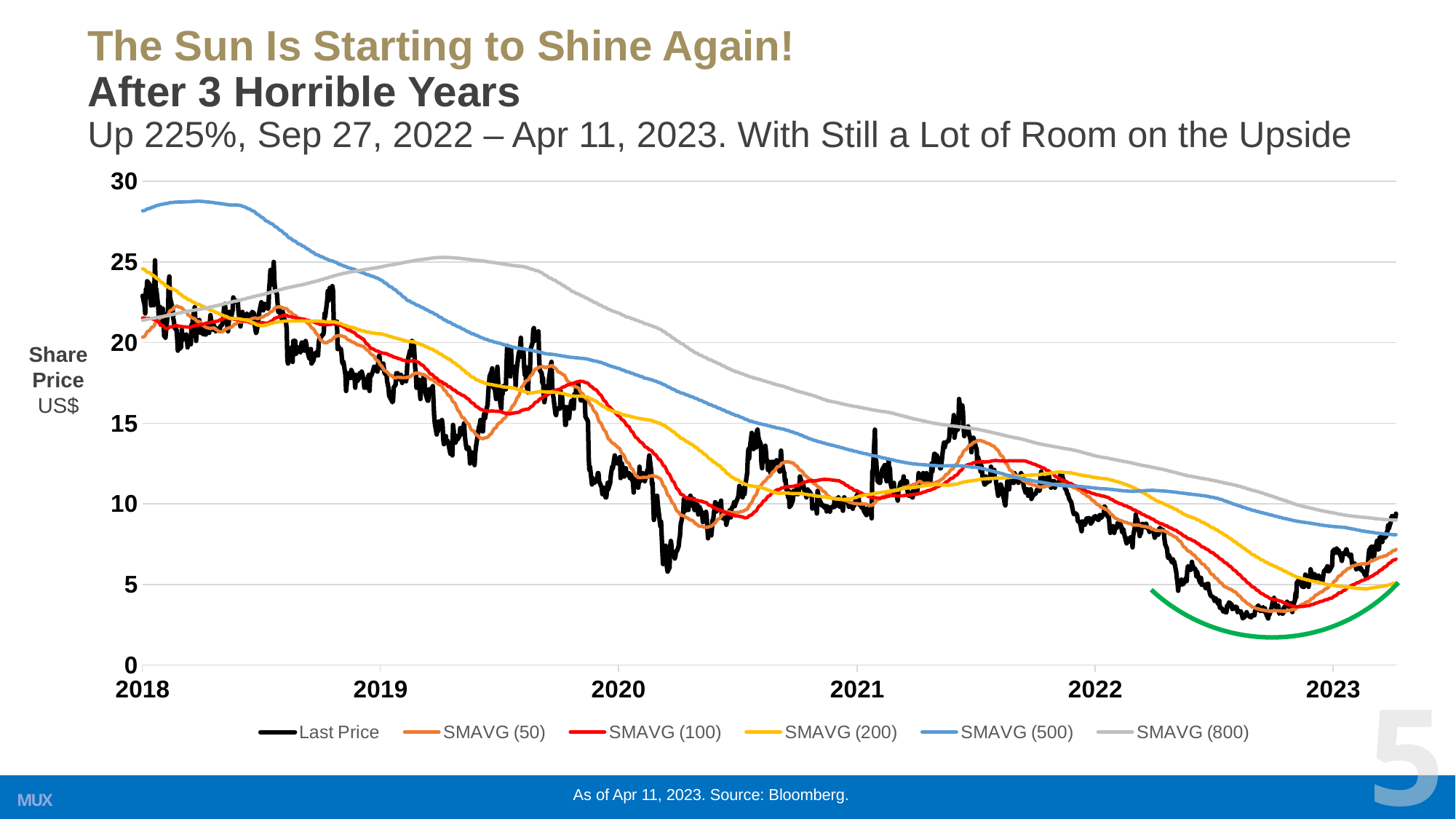
Does the Last Price series generally rise or fall from 2018 to late 2022? fall At the start of 2018, which is higher, SMAVG (500) or SMAVG (800)? SMAVG (500) What kind of chart is shown on the slide? line chart How many series does the legend list? 6 Which series is drawn in black? Last Price Is the value of SMAVG (800) at the start of 2023 greater or less than 5? greater Which series are listed in the legend? Last Price, SMAVG (50), SMAVG (100), SMAVG (200), SMAVG (500), SMAVG (800) Is the value of Last Price at the start of 2023 greater or less than 10? less Is the value of Last Price at the start of 2020 greater or less than 10? greater How many year labels are shown on the x axis? 6 Does the SMAVG (800) series rise or fall from 2020 to 2023? fall